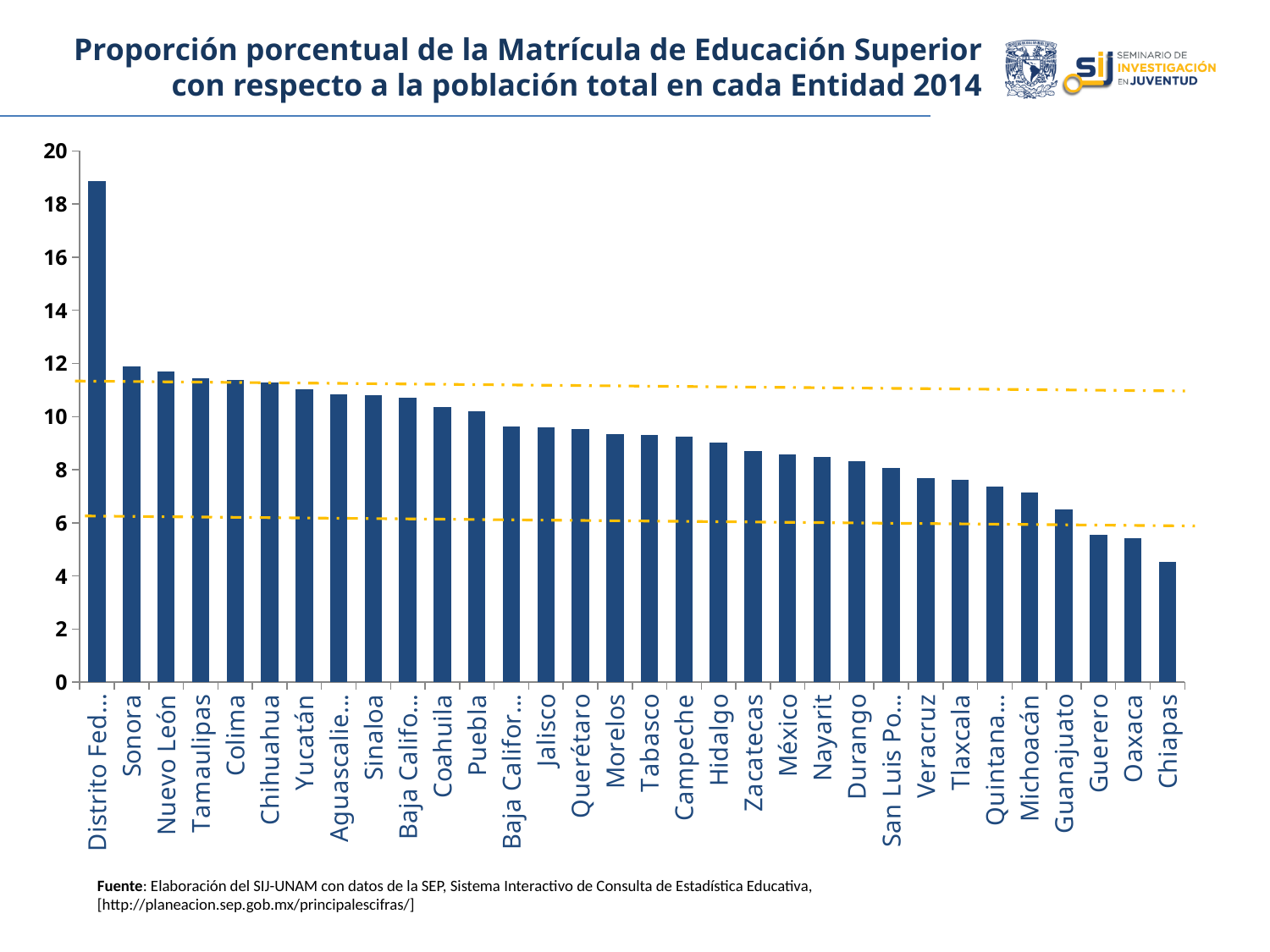
Which is larger, the value for Oaxaca or the value for Chiapas? Oaxaca Is the value for Chiapas greater or less than 6? less How many entities (bars) are plotted in the chart? 32 Is the value for Veracruz greater or less than 8? less Is the value for Distrito Federal greater or less than 18? greater What year does the chart title refer to? 2014 Which entity has the highest proportion in the chart? Distrito Federal Which entity has the lowest proportion in the chart? Chiapas What kind of chart is shown on the slide? bar chart Do the bar values rise or fall moving from left to right along the x axis? fall